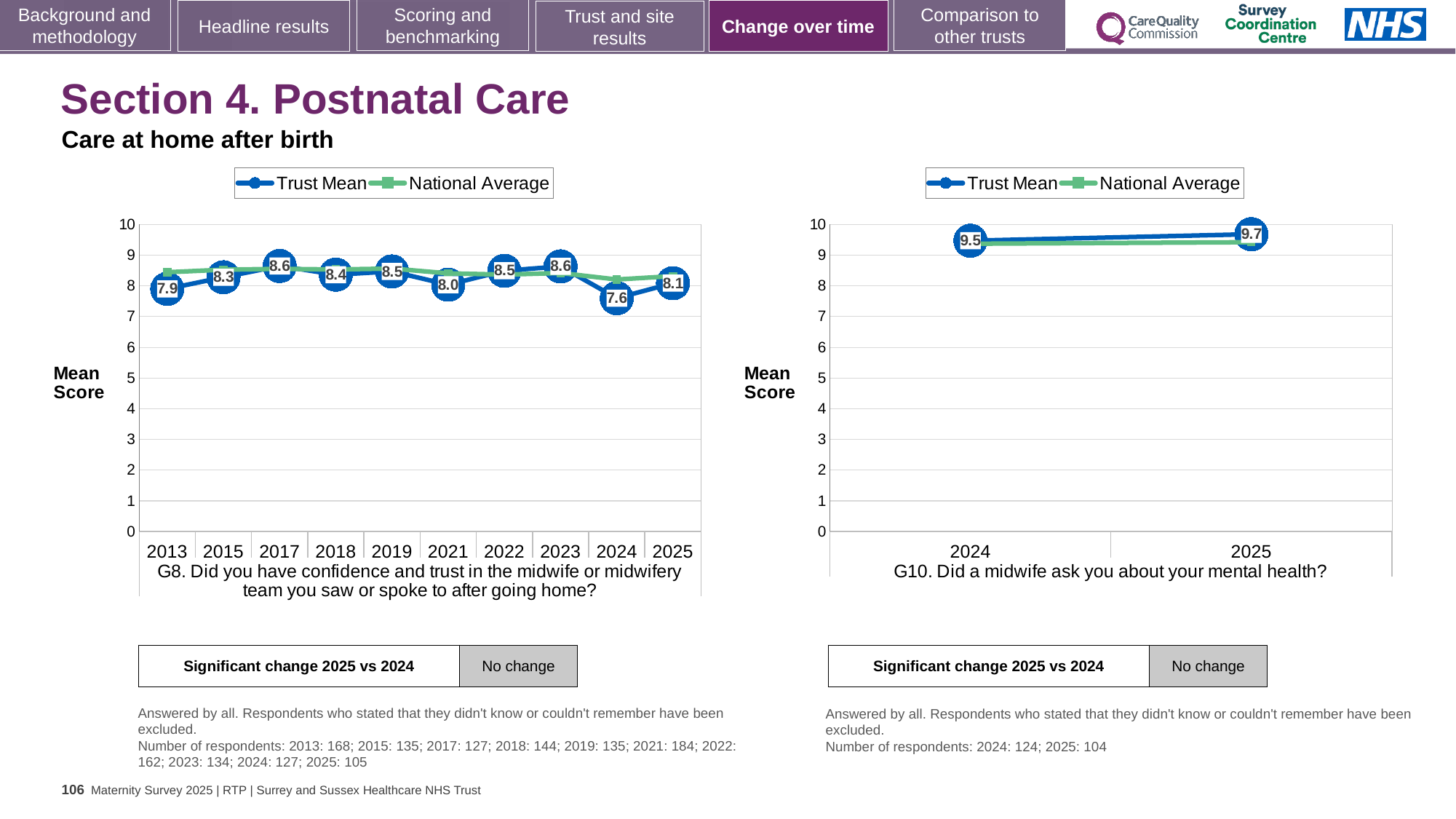
In the G8 chart on the left, what is the Trust Mean score for 2024? 7.6 In the G10 chart on the right, does the Trust Mean rise or fall from 2024 to 2025? Rise In the G8 chart on the left, which is larger, the Trust Mean score for 2017 or for 2021? 2017 In the G10 chart on the right, what is the Trust Mean score for 2025? 9.7 How many years are plotted on the x axis of the G8 chart on the left? 10 In the G8 chart on the left, what is the Trust Mean score for 2013? 7.9 In the G8 chart on the left, which year has the lowest Trust Mean score? 2024 What kind of chart is the G10 chart on the right? Line chart In the G8 chart on the left, what is the difference between the Trust Mean scores for 2025 and 2024? 0.5 In the G10 chart on the right, what is the difference between the Trust Mean scores for 2025 and 2024? 0.2 How many series does the legend of the G10 chart on the right list? 2 In the G8 chart on the left, is the National Average value for 2013 greater or less than 8? greater